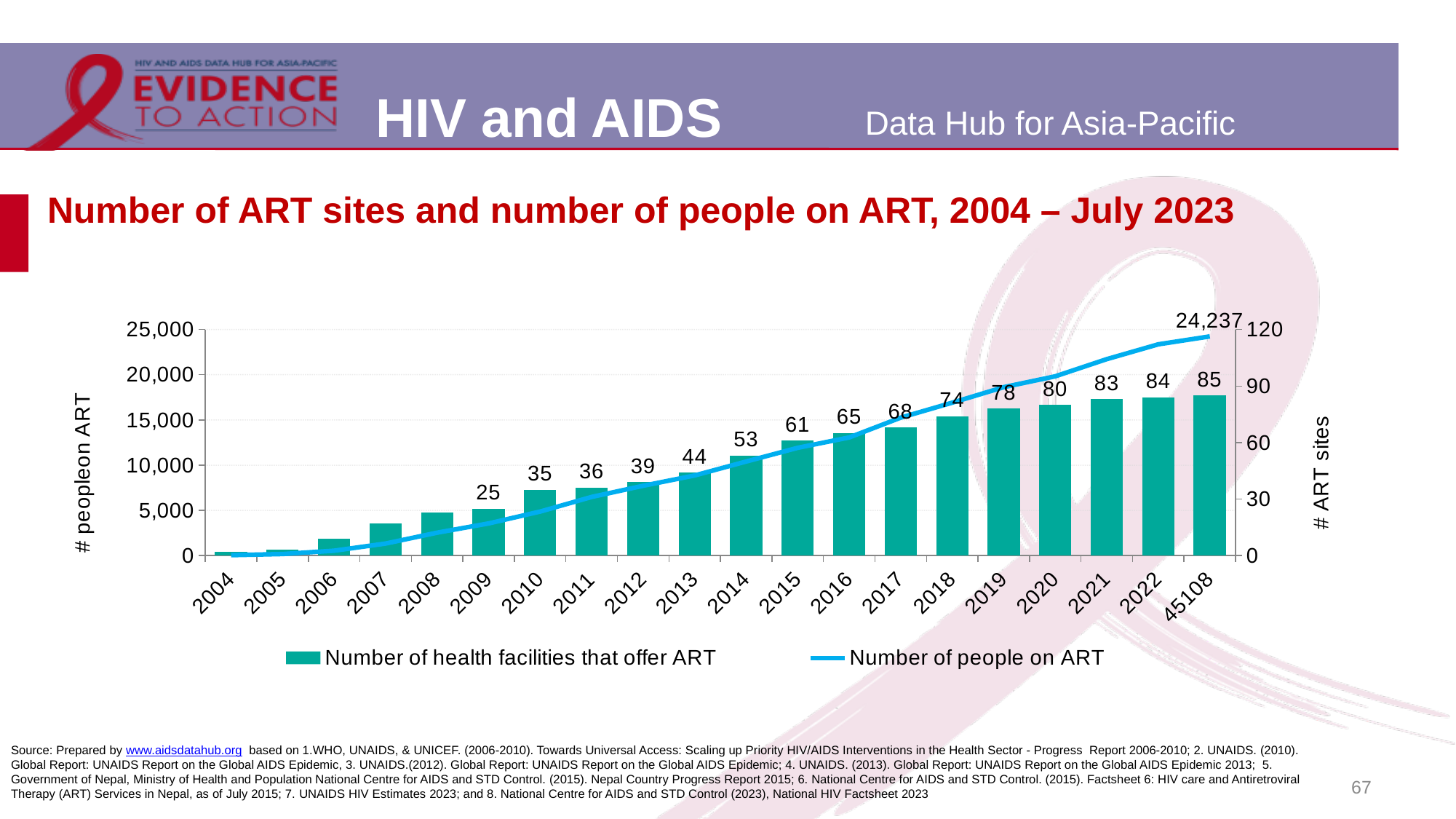
Is the number of health facilities that offer ART in 2007 greater or less than 30? less What is the labelled number of people on ART at the final point of the line? 24,237 Which year has more health facilities offering ART, 2014 or 2015? 2015 What is the number of health facilities that offer ART in 2022? 84 What kind of chart is shown on the slide? Combination bar and line chart Which category has the highest number of health facilities that offer ART? 45108 What is the difference between the number of ART facilities in 2022 and in 2009? 59 Does the number of people on ART rise or fall from 2004 to the last point? Rise How many series does the legend list? 2 How many health facilities offered ART in 2009? 25 How many categories are shown on the x axis? 20 What is the title of the right-hand vertical axis? # ART sites